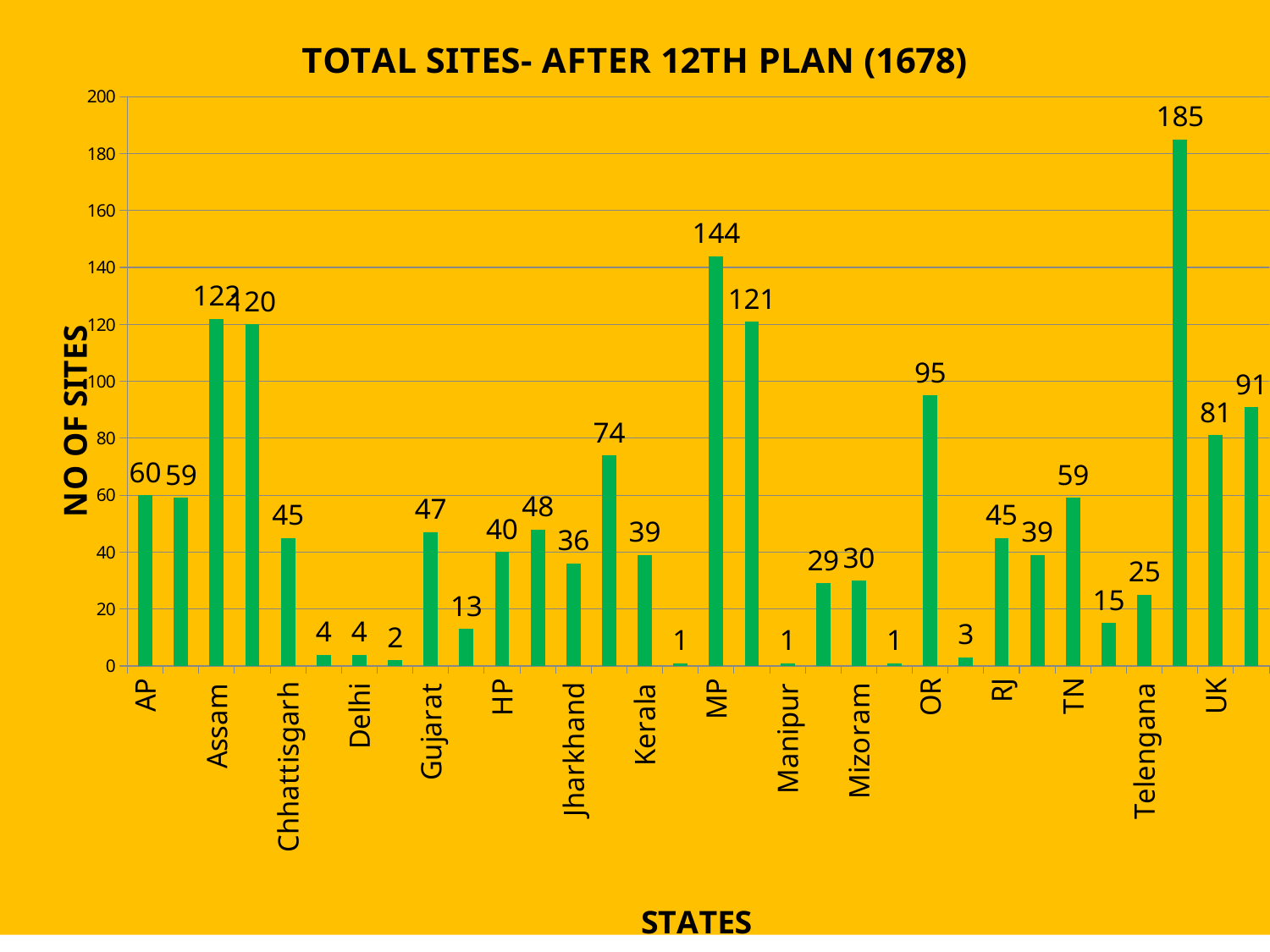
What is the number of sites for Telangana? 25 Is the value for Kerala greater or less than 60? less What is the highest value shown by any bar in the chart? 185 What is the number of sites for UK? 81 What is the number of sites for MP? 144 What is the title of the chart? TOTAL SITES- AFTER 12TH PLAN (1678) How many bars are plotted in the chart? 32 Which has more sites, Assam or TN? Assam What kind of chart is shown on the slide? Bar chart What is the number of sites for Jharkhand? 36 What is the difference between the number of sites for MP and for OR? 49 What is the number of sites for OR? 95